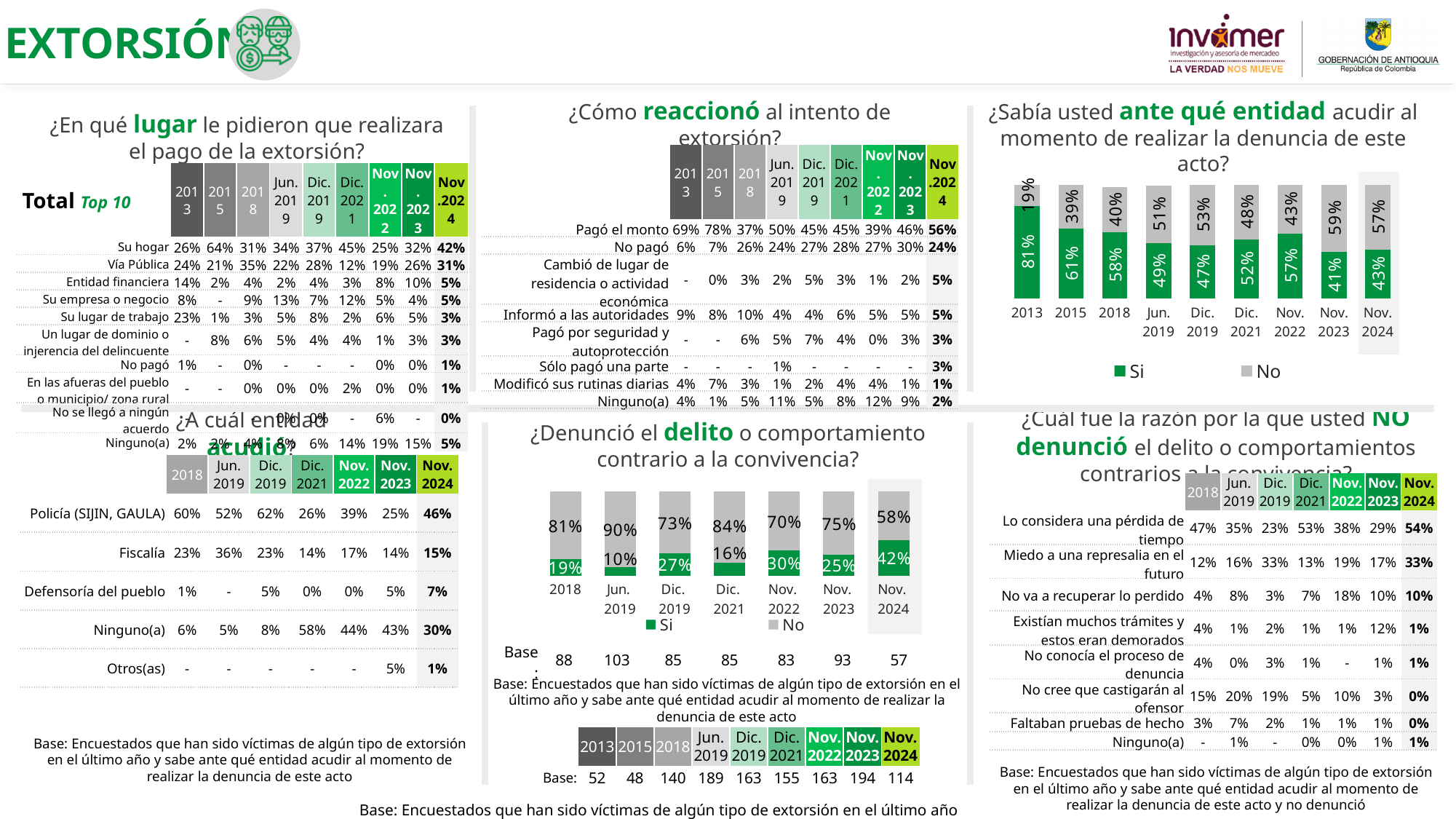
In the chart '¿Denunció el delito o comportamiento contrario a la convivencia?', is the 'Si' value for Nov. 2022 larger or smaller than the 'Si' value for Nov. 2023? larger In the chart '¿Sabía usted ante qué entidad acudir al momento de realizar la denuncia de este acto?', how many periods are shown on the x axis? 9 In the chart '¿Sabía usted ante qué entidad acudir al momento de realizar la denuncia de este acto?', which period has the lowest 'Si' value? Nov. 2023 In the chart '¿Denunció el delito o comportamiento contrario a la convivencia?', how many series does the legend list? 2 In the chart '¿Denunció el delito o comportamiento contrario a la convivencia?', what is the 'Si' value for Nov. 2024? 42% In the chart '¿Sabía usted ante qué entidad acudir al momento de realizar la denuncia de este acto?', what is the 'No' value for Nov. 2024? 57% In the chart '¿Denunció el delito o comportamiento contrario a la convivencia?', which period has the highest 'No' value? Jun. 2019 In the chart '¿Sabía usted ante qué entidad acudir al momento de realizar la denuncia de este acto?', what is the difference between the 'Si' values for 2013 and 2015? 20% In the chart '¿Sabía usted ante qué entidad acudir al momento de realizar la denuncia de este acto?', what is the 'Si' value for 2013? 81% In the chart '¿Denunció el delito o comportamiento contrario a la convivencia?', what is the base (number of respondents) for Nov. 2024? 57 In the chart '¿Sabía usted ante qué entidad acudir al momento de realizar la denuncia de este acto?', which period has the highest 'Si' value? 2013 What type of chart is used for '¿Denunció el delito o comportamiento contrario a la convivencia?'? Stacked bar chart